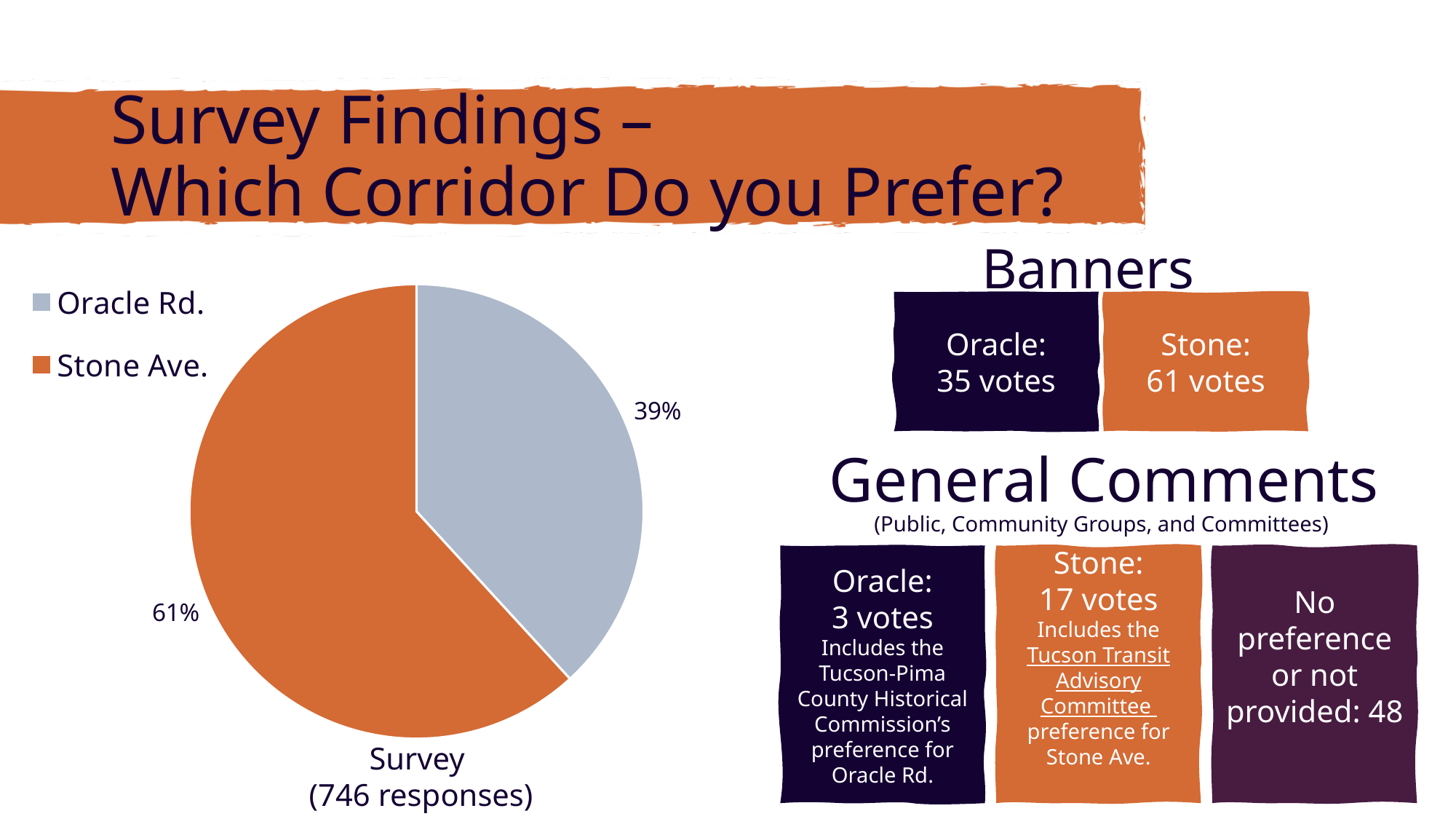
What share of the pie does Stone Ave. have? 61% Which slice is larger, Oracle Rd. or Stone Ave.? Stone Ave. How many slices does the pie chart have? 2 What label appears below the pie chart? Survey (746 responses) Is the Oracle Rd. share of the pie greater or less than 50%? less What type of chart is shown on the slide? pie chart Which corridor has the largest slice of the pie? Stone Ave. How many entries does the legend list? 2 Which corridor has the smallest slice of the pie? Oracle Rd. What share of the pie does Oracle Rd. have? 39% What is the difference in percentage points between the Stone Ave. and Oracle Rd. slices? 22 What colour is the Stone Ave. slice of the pie? orange